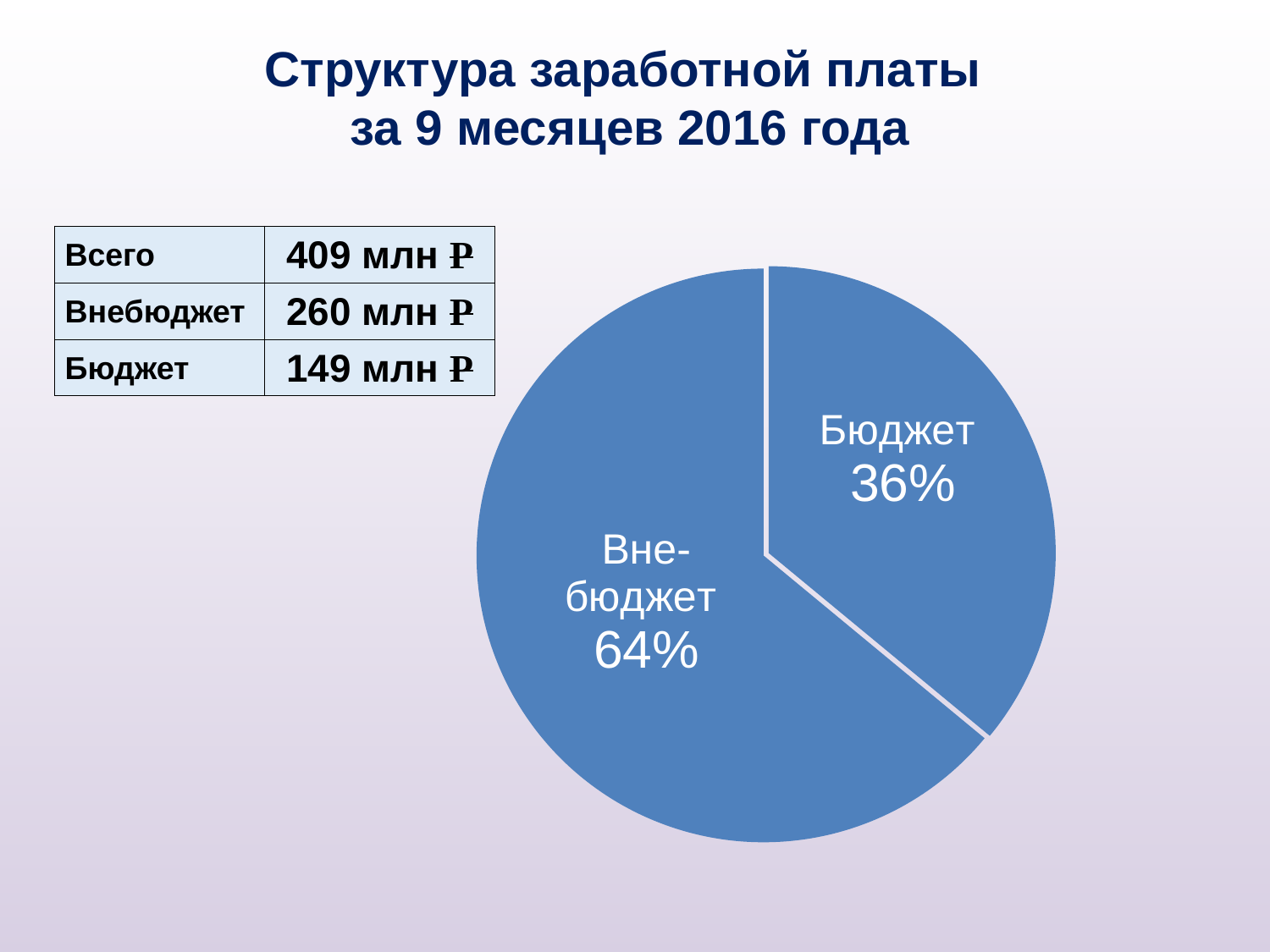
Is the share of the Бюджет slice greater or less than 50%? less What kind of chart is shown on the slide? pie chart What is the difference in percentage points between the Внебюджет slice and the Бюджет slice? 28 What share of the pie does the Бюджет slice represent? 36% Which slice of the pie is the largest? Внебюджет Which slice of the pie is the smallest? Бюджет What is the title of the slide containing the pie chart? Структура заработной платы за 9 месяцев 2016 года What colour are the slices of the pie chart? blue Which is larger, the Бюджет slice or the Внебюджет slice? Внебюджет How many slices does the pie chart have? 2 What share of the pie does the Внебюджет slice represent? 64%